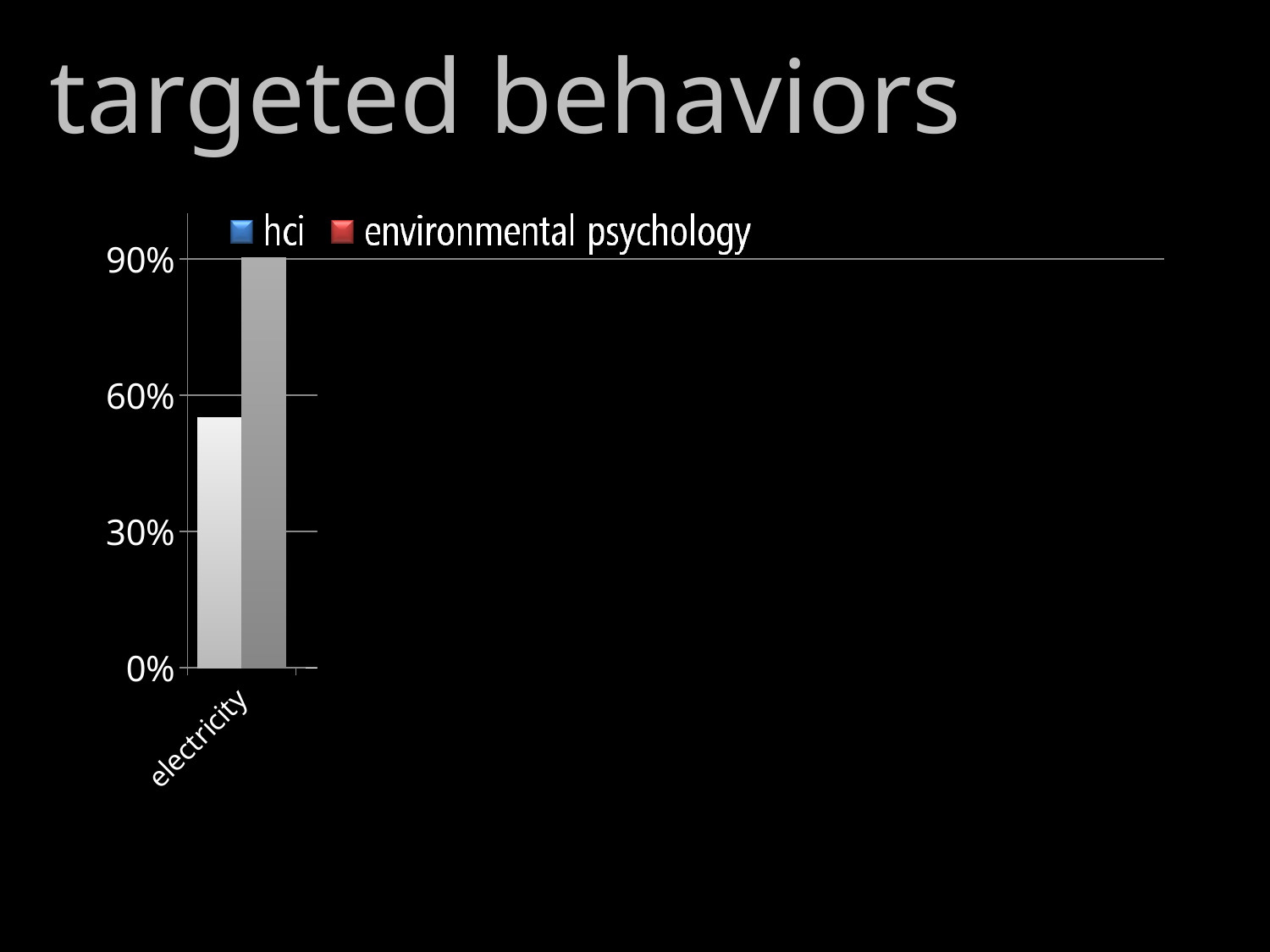
Which series has the lowest bar for electricity? hci Which series has the highest bar for electricity? environmental psychology What is the title of the slide containing the chart? targeted behaviors Is the hci value for electricity greater or less than 30%? greater What kind of chart is shown on the slide? bar chart How many series does the legend list? 2 Is the hci value for electricity greater or less than 60%? less What is the label of the category on the x axis? electricity Is the environmental psychology value for electricity greater or less than 60%? greater Which series has the larger value for electricity, hci or environmental psychology? environmental psychology How many categories are shown on the x axis? 1